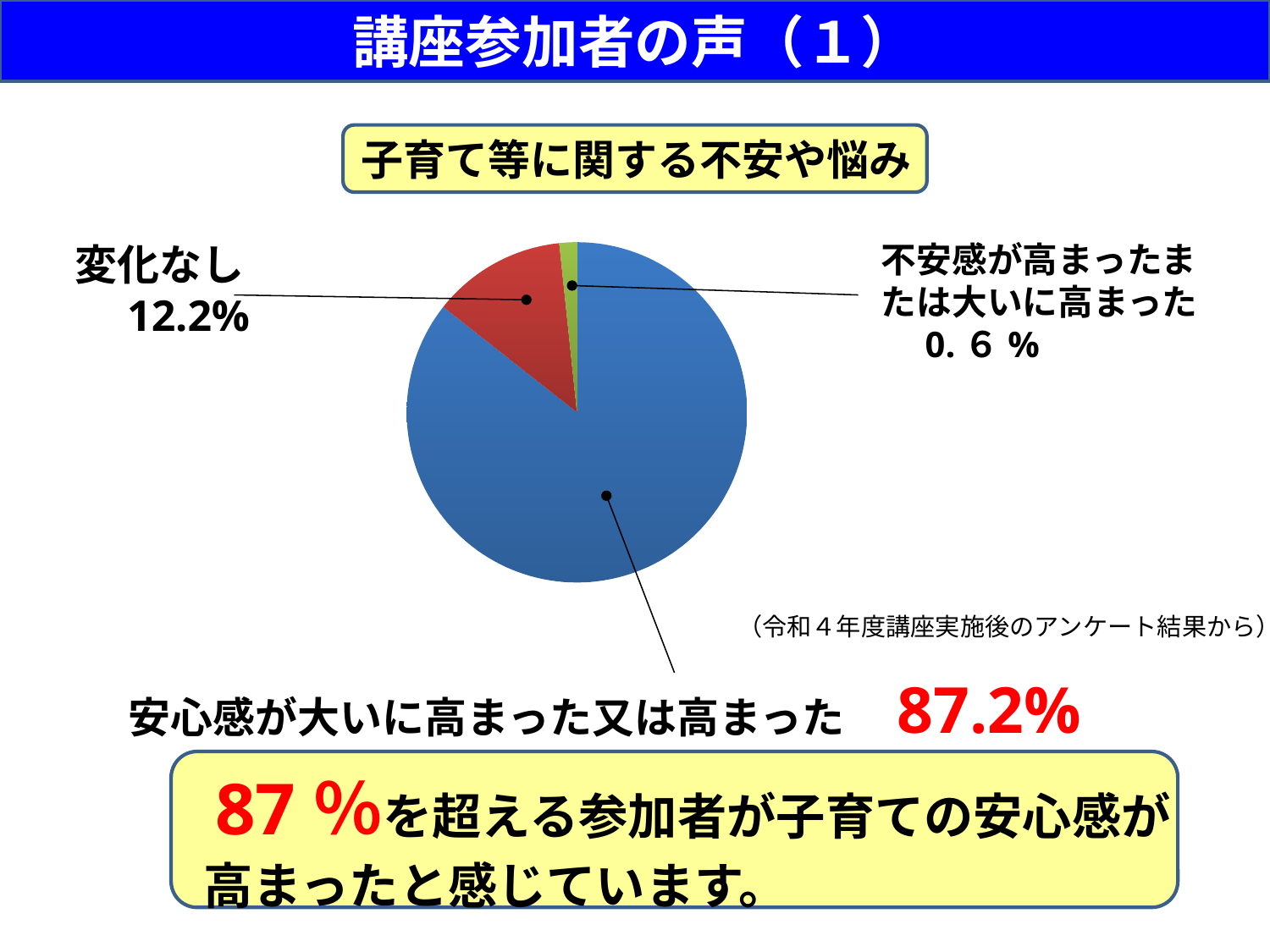
What share of the pie is labelled 変化なし? 12.2% Which category has the smallest slice of the pie? 不安感が高まったまたは大いに高まった Which category has the largest slice of the pie? 安心感が大いに高まった又は高まった What kind of chart is shown on the slide? pie chart What is the heading shown above the pie chart? 子育て等に関する不安や悩み Which is larger, the share for 変化なし or the share for 不安感が高まったまたは大いに高まった? 変化なし What colour is the slice for 変化なし? red What share of the pie is labelled 不安感が高まったまたは大いに高まった? 0.6% What is the difference in percentage points between 変化なし and 不安感が高まったまたは大いに高まった? 11.6% How many slices does the pie chart have? 3 What share of the pie is labelled 安心感が大いに高まった又は高まった? 87.2% What is the difference in percentage points between 安心感が大いに高まった又は高まった and 変化なし? 75.0%